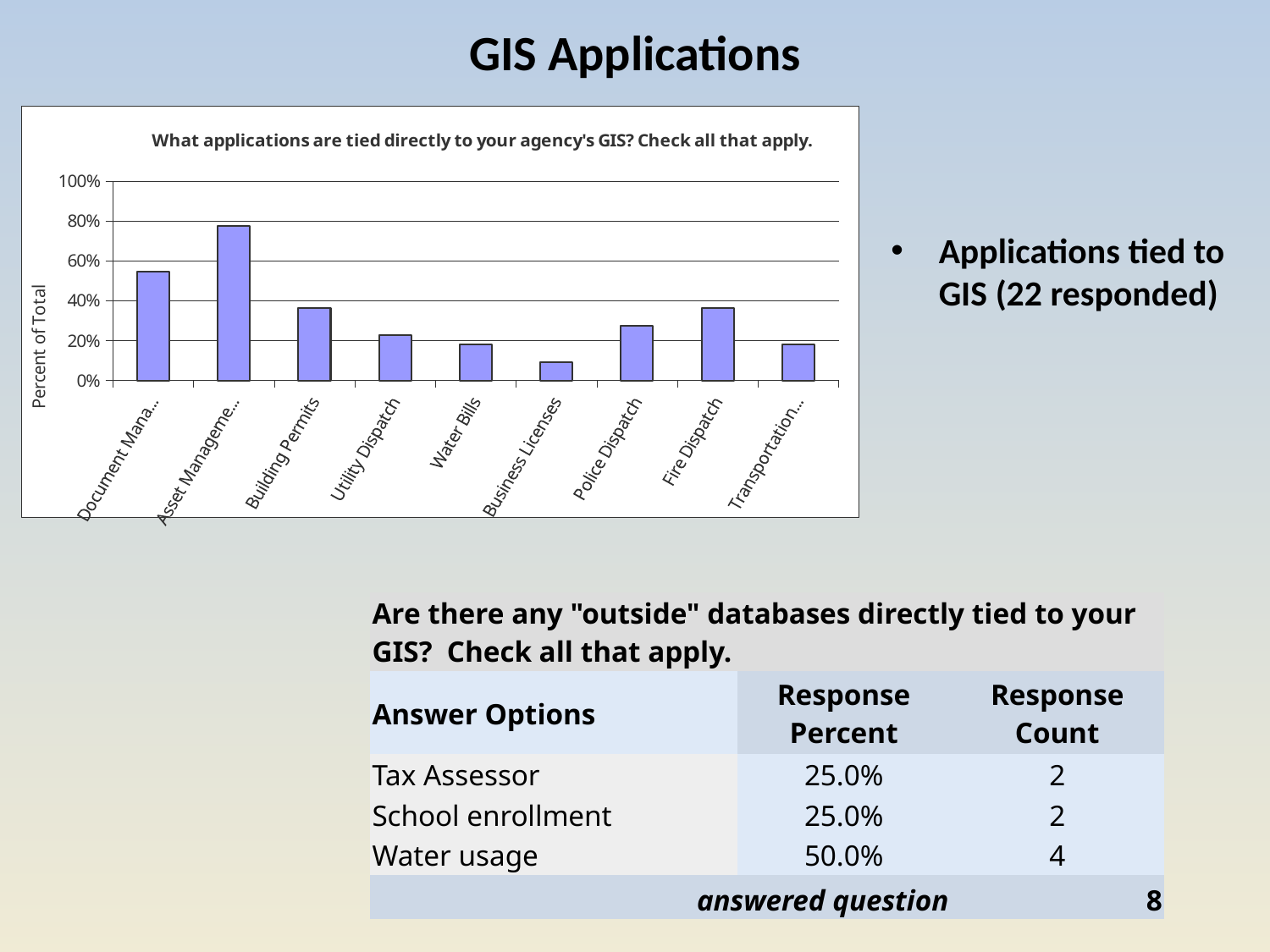
How many categories are plotted in the bar chart? 9 What kind of chart is shown on the slide? bar chart Which is larger, the value for Building Permits or the value for Utility Dispatch? Building Permits Which is larger, the value for Fire Dispatch or the value for Water Bills? Fire Dispatch Is the value for Business Licenses greater or less than 20%? less Which is larger, the value for Police Dispatch or the value for Business Licenses? Police Dispatch Is the value for Building Permits greater or less than 20%? greater What is the label on the vertical axis of the chart? Percent of Total Which category has the lowest value in the bar chart? Business Licenses What is the title of the chart? What applications are tied directly to your agency's GIS? Check all that apply. Is the value for Fire Dispatch greater or less than 20%? greater